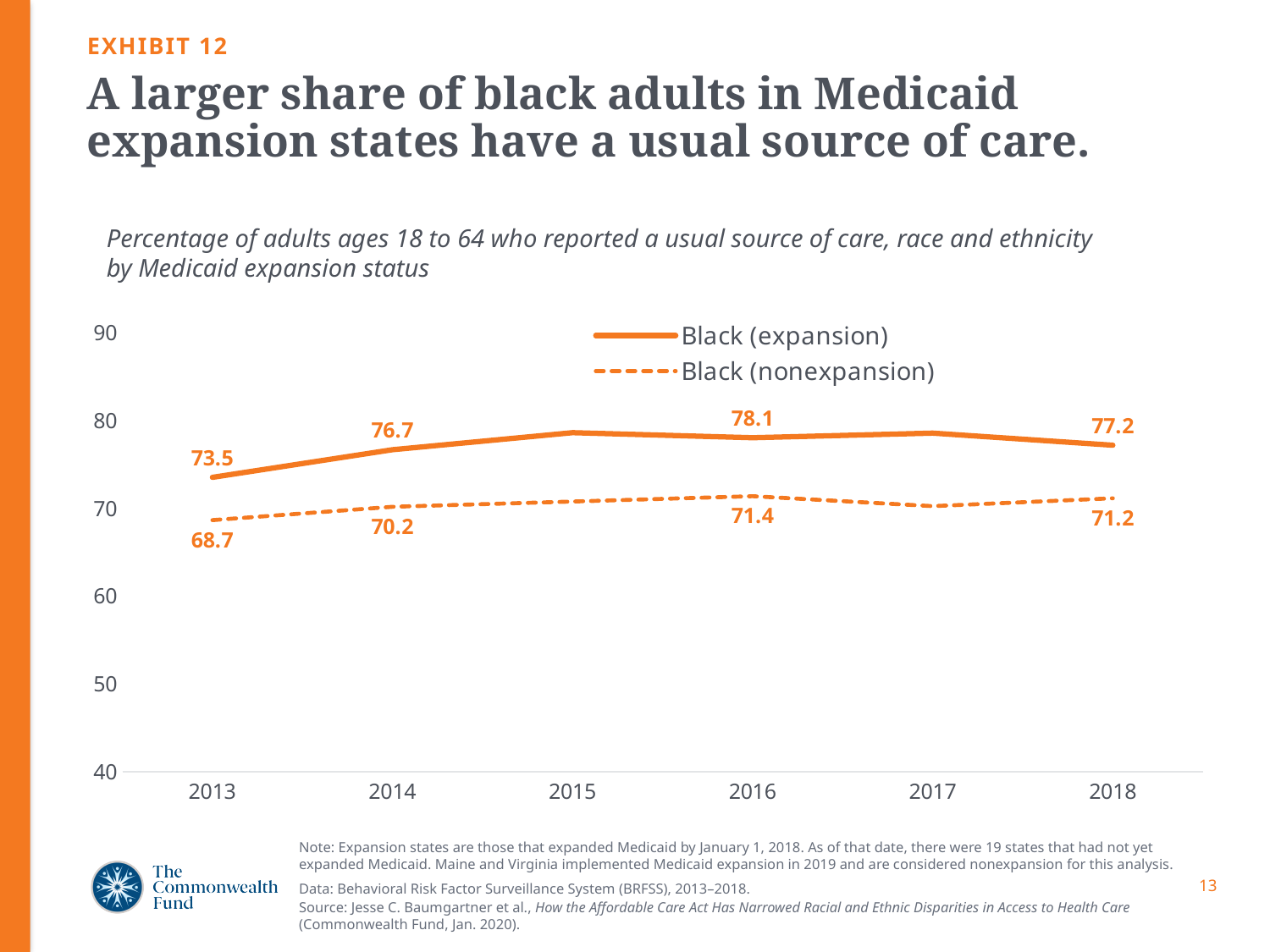
Among the labeled values, in which year is Black (expansion) highest? 2016 How many series does the legend list? 2 Among the labeled values, in which year is Black (nonexpansion) lowest? 2013 Which series has the larger value in 2018, Black (expansion) or Black (nonexpansion)? Black (expansion) What is the value for Black (nonexpansion) in 2018? 71.2 What is the value for Black (nonexpansion) in 2014? 70.2 What is the value for Black (expansion) in 2016? 78.1 How many years are shown on the x axis? 6 What kind of chart is shown on the slide? Line chart What is the difference between Black (expansion) and Black (nonexpansion) in 2013? 4.8 Is the value for Black (expansion) in 2015 greater or less than 70? greater What is the value for Black (expansion) in 2013? 73.5